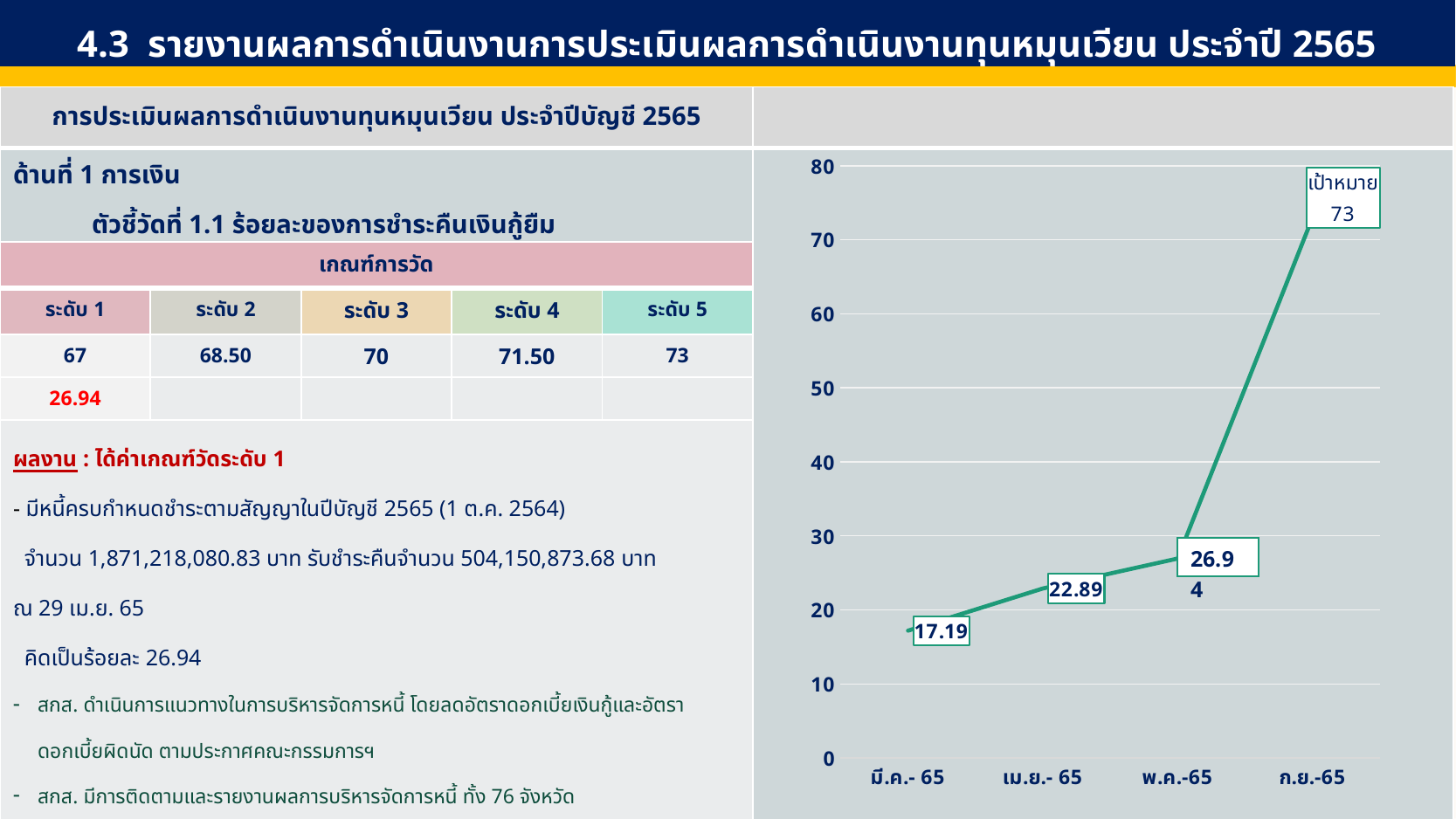
What is the value plotted for เม.ย.- 65 on the line chart? 22.89 Which category on the line chart has the lowest value? มี.ค.- 65 Which is larger on the line chart, the value for เม.ย.- 65 or the value for พ.ค.-65? พ.ค.-65 What value is shown for ก.ย.-65 on the line chart? 73 What is the difference between the values for เม.ย.- 65 and มี.ค.- 65 on the line chart? 5.70 What is the value plotted for พ.ค.-65 on the line chart? 26.94 Do the values on the line chart rise or fall from มี.ค.- 65 to ก.ย.-65? rise Which category on the line chart has the highest value? ก.ย.-65 What kind of chart is shown on the right side of the slide? line chart How many data points are plotted on the line chart? 4 What label text is shown next to the last point on the line chart? เป้าหมาย 73 What is the value plotted for มี.ค.- 65 on the line chart? 17.19